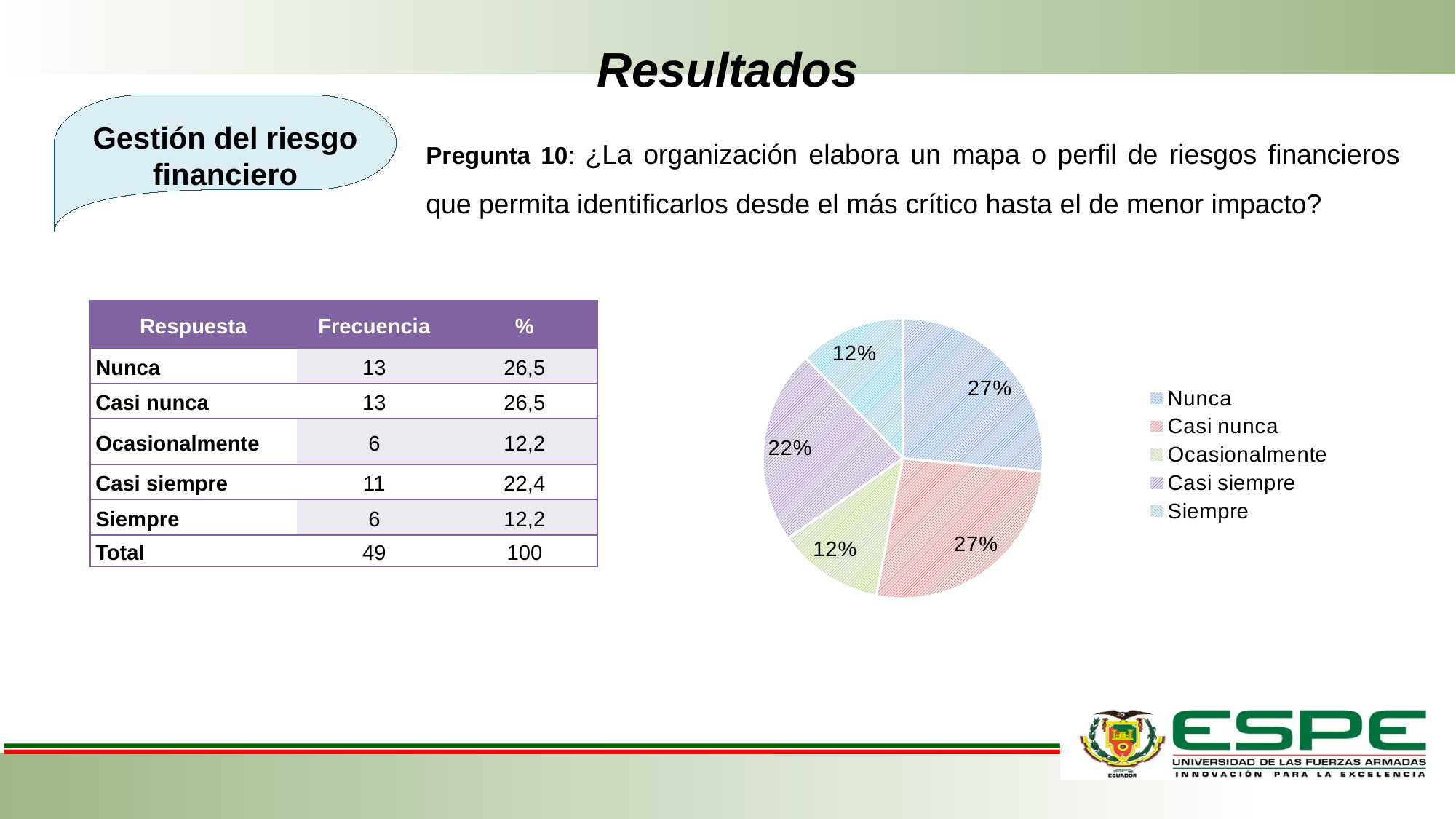
Which slice is larger in the pie chart, Nunca or Siempre? Nunca How many entries does the legend of the pie chart list? 5 What share of the pie chart does Ocasionalmente represent? 12% What share of the pie chart does Casi nunca represent? 27% By how many percentage points does the Casi nunca slice exceed the Casi siempre slice in the pie chart? 5 Which slice is larger in the pie chart, Casi siempre or Ocasionalmente? Casi siempre How many slices does the pie chart have? 5 What kind of chart is shown on the slide? pie chart What share of the pie chart does Nunca represent? 27% What share of the pie chart does Casi siempre represent? 22% Which legend entry in the pie chart is listed last? Siempre What share of the pie chart does Siempre represent? 12%